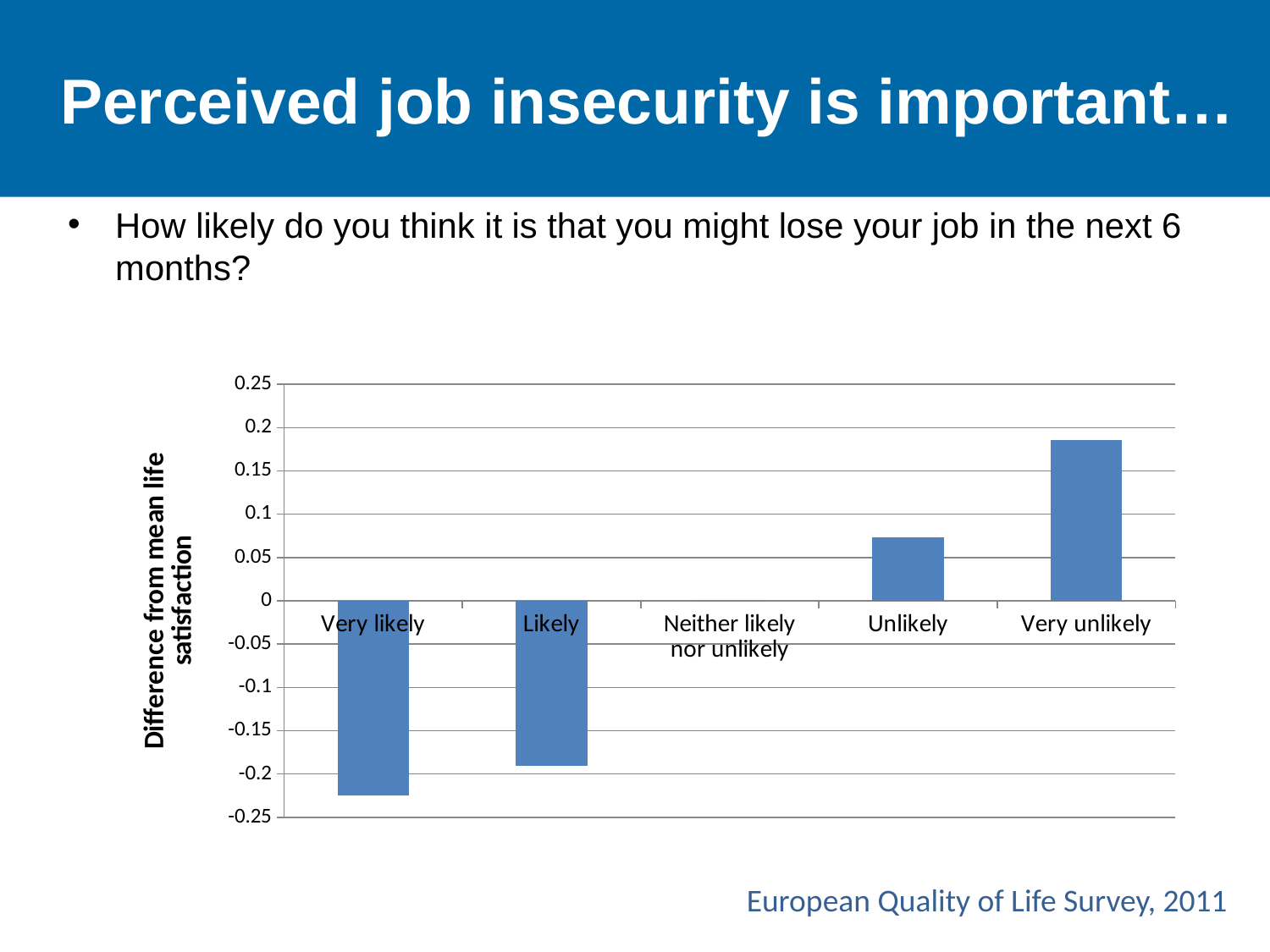
What is the title of the vertical axis of the chart? Difference from mean life satisfaction How many categories are shown on the x axis of the chart? 5 Which has the lower value, Very likely or Likely? Very likely Is the value for Unlikely greater or less than 0.05? greater Is the value for Likely greater or less than -0.15? less Do the values rise or fall moving from Very likely to Very unlikely along the x axis? rise Which category has the highest difference from mean life satisfaction? Very unlikely What kind of chart is shown on the slide? bar chart Is the value for Very likely greater or less than -0.2? less Which has the larger value, Unlikely or Very unlikely? Very unlikely Which category has the lowest difference from mean life satisfaction? Very likely